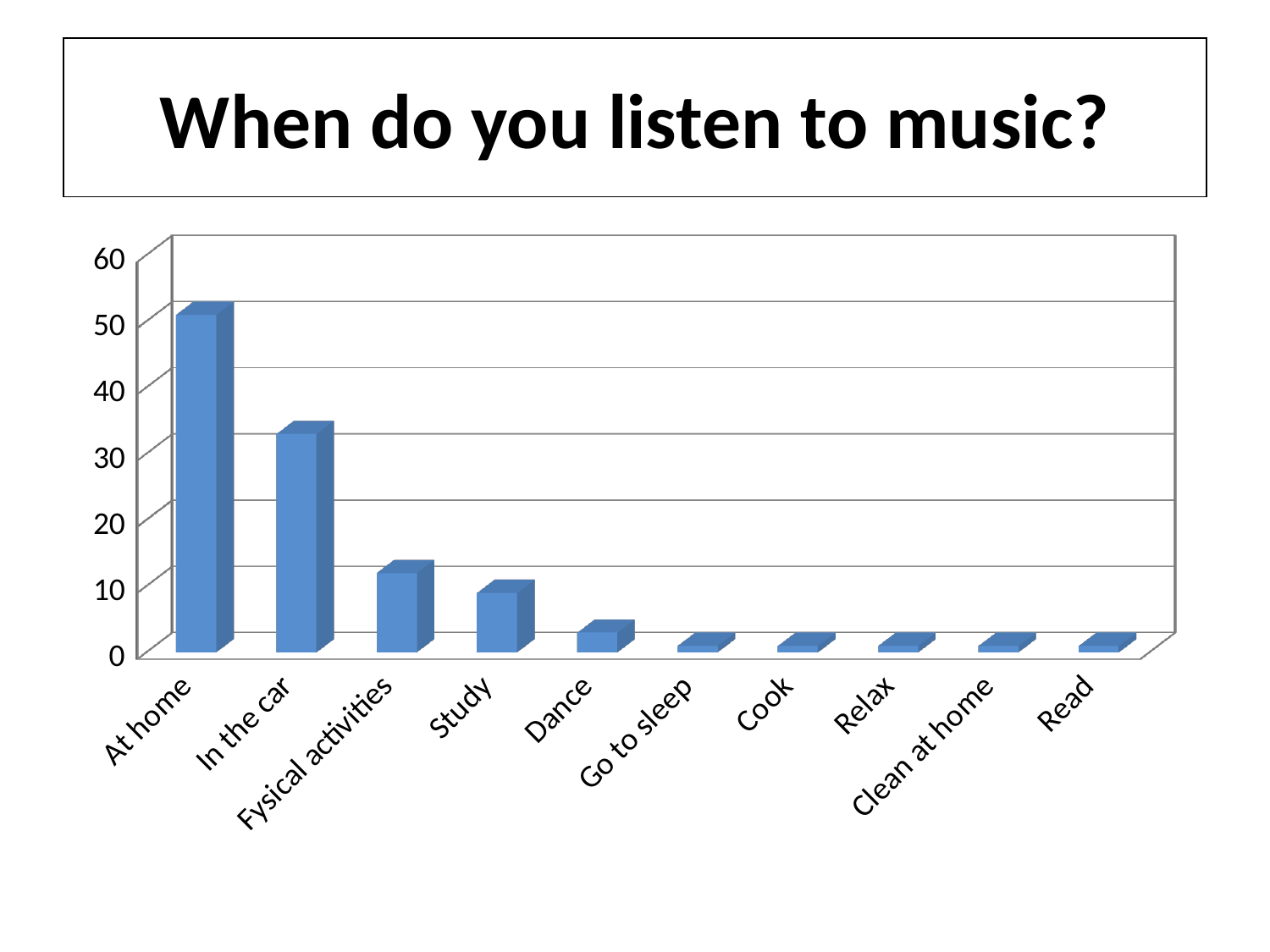
What is the title of the slide? When do you listen to music? Which is larger, the value for Study or the value for Dance? Study Is the value for Dance greater or less than 10? less Is the value for In the car greater or less than 40? less Is the value for At home greater or less than 40? greater How many categories are shown on the x axis of the chart? 10 Which is larger, the value for At home or the value for In the car? At home Do the values generally rise or fall moving from left to right along the x axis? fall Which category has the highest value in the chart? At home What kind of chart is shown on the slide? bar chart